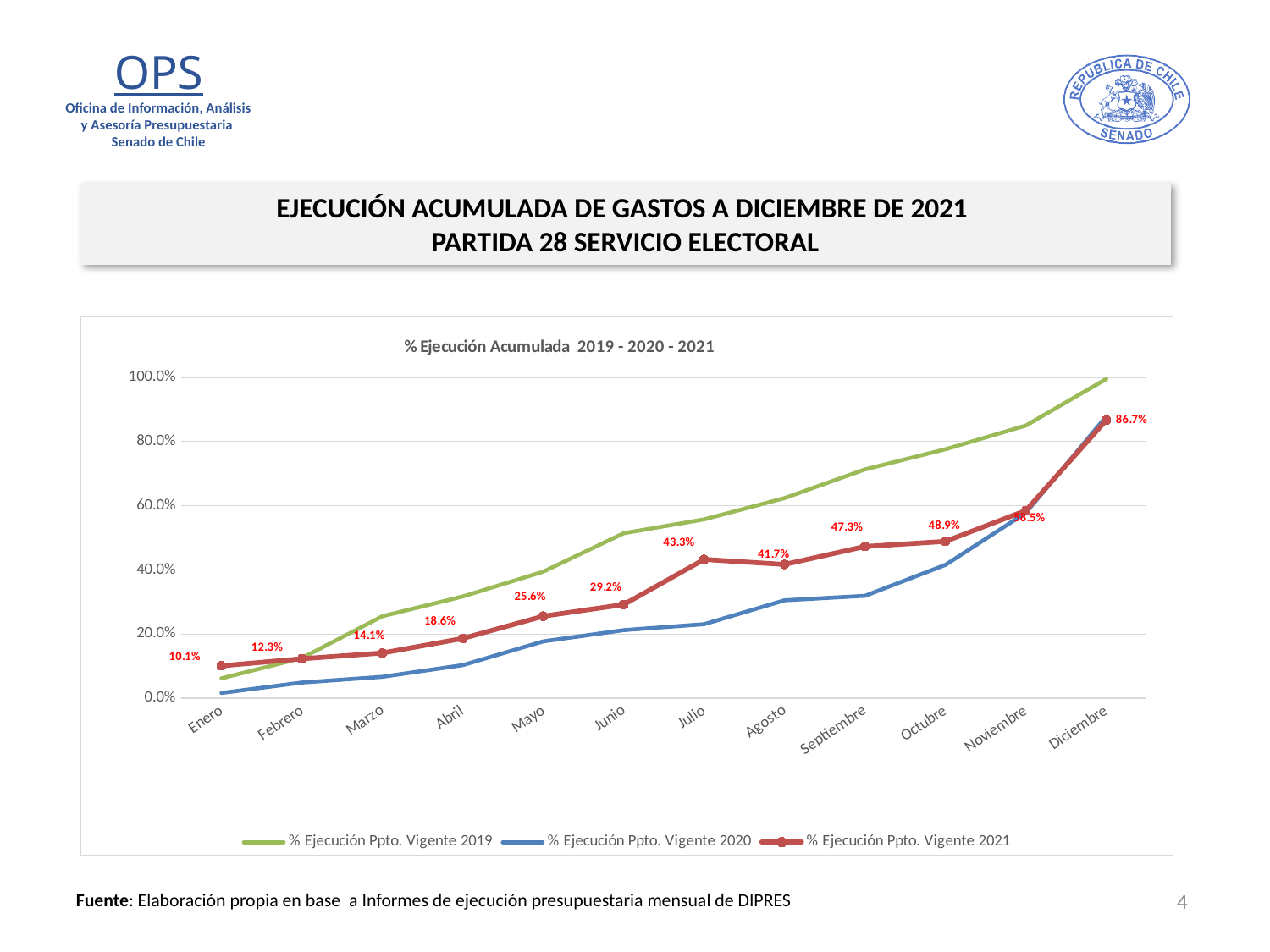
Is the value for Diciembre in the % Ejecución Ppto. Vigente 2019 series greater or less than 80.0%? greater What is the value for Julio in the % Ejecución Ppto. Vigente 2021 series? 43.3% What is the value for Diciembre in the % Ejecución Ppto. Vigente 2021 series? 86.7% What kind of chart is shown on the slide? line chart In the % Ejecución Ppto. Vigente 2021 series, which is larger, the value for Julio or the value for Agosto? Julio In the % Ejecución Ppto. Vigente 2021 series, which month has the lowest value? Enero What is the value for Enero in the % Ejecución Ppto. Vigente 2021 series? 10.1% How many months are shown on the x axis? 12 What is the title of the chart? % Ejecución Acumulada 2019 - 2020 - 2021 What is the difference between the Octubre and Septiembre values in the % Ejecución Ppto. Vigente 2021 series? 1.6% How many series does the legend list? 3 In the % Ejecución Ppto. Vigente 2021 series, which month has the highest value? Diciembre